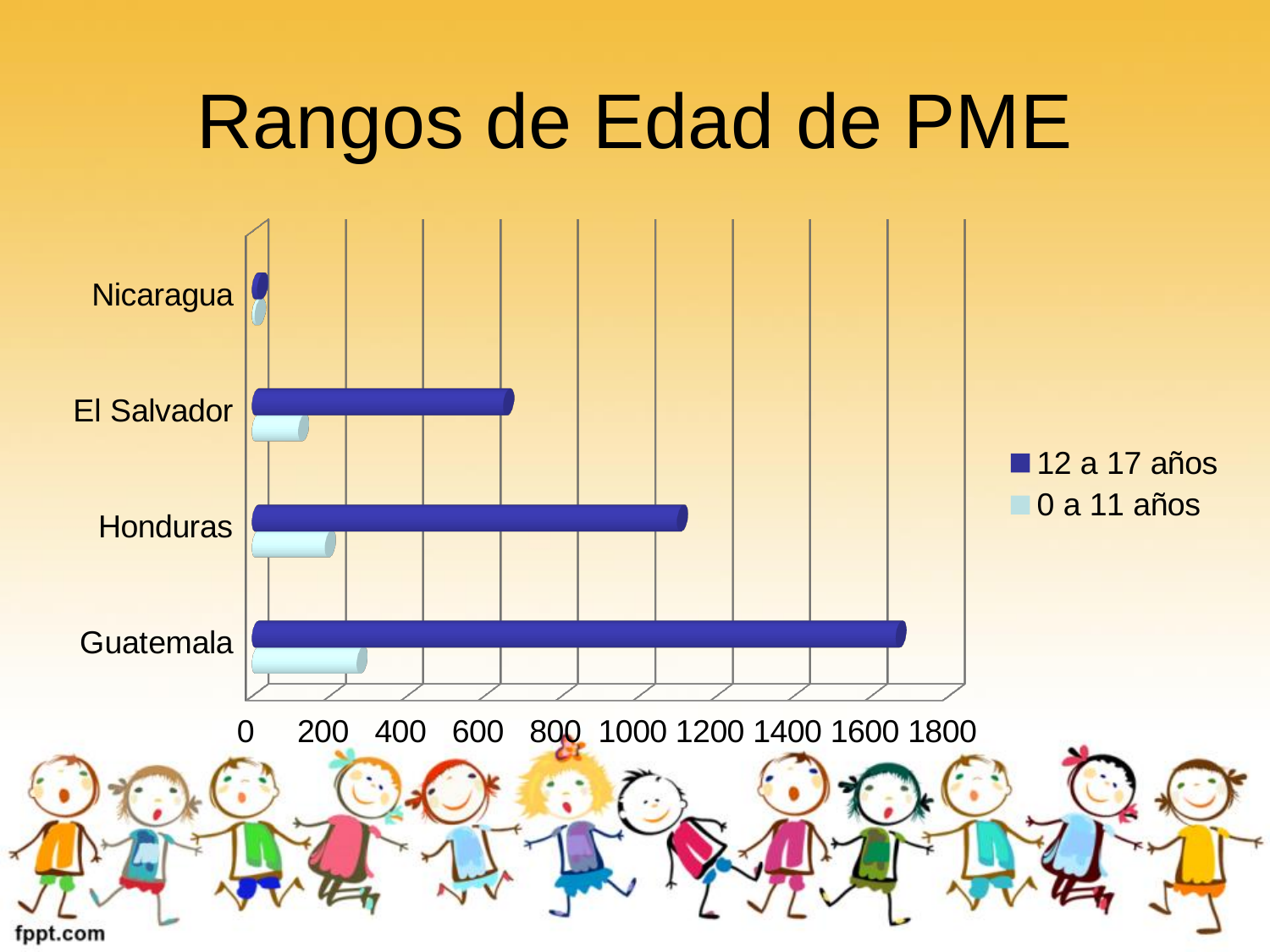
Which country has the highest value for the '12 a 17 años' series? Guatemala Is the '12 a 17 años' value for Honduras greater or less than 1000? greater Is the '12 a 17 años' value for El Salvador greater or less than 800? less Which legend entry is shown in dark blue? 12 a 17 años What kind of chart is shown on the slide? bar chart Is the '12 a 17 años' value for Guatemala greater or less than 1600? greater How many countries are shown on the chart? 4 Which is larger for the '12 a 17 años' series, Honduras or El Salvador? Honduras Which country has the lowest value for the '12 a 17 años' series? Nicaragua How many series does the legend list? 2 Which country has the highest value for the '0 a 11 años' series? Guatemala What is the title of the chart? Rangos de Edad de PME